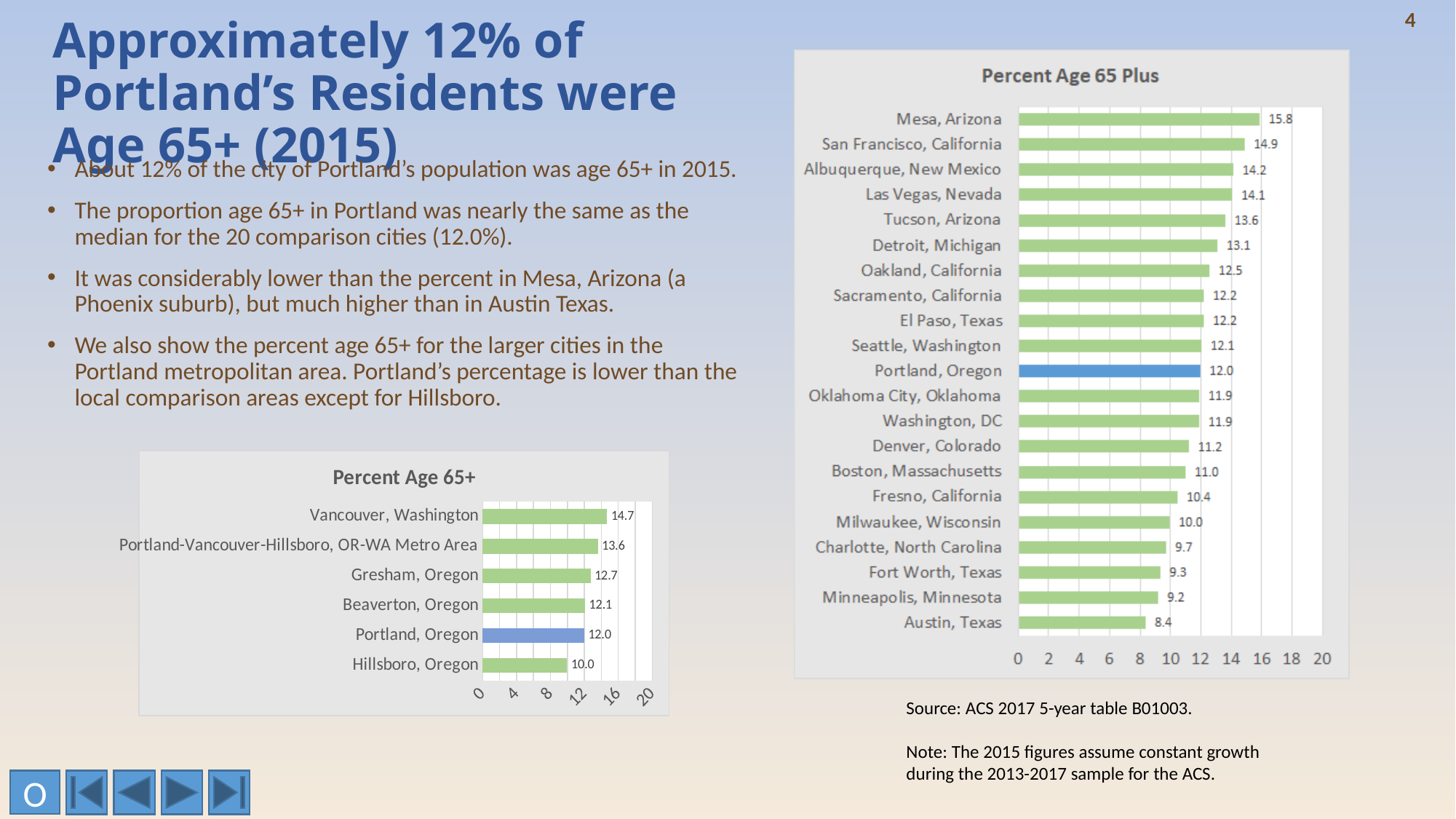
In the 'Percent Age 65+' chart at the bottom left, what is the value for Vancouver, Washington? 14.7 What type of chart is the 'Percent Age 65 Plus' chart on the right? Bar chart In the 'Percent Age 65 Plus' chart on the right, which city has the lowest value? Austin, Texas In the 'Percent Age 65 Plus' chart on the right, what is the value for Mesa, Arizona? 15.8 In the 'Percent Age 65 Plus' chart on the right, which is larger: Detroit, Michigan or Denver, Colorado? Detroit, Michigan In the 'Percent Age 65+' chart at the bottom left, what is the difference between Gresham, Oregon and Portland, Oregon? 0.7 In the 'Percent Age 65 Plus' chart on the right, what is the value for Seattle, Washington? 12.1 In the 'Percent Age 65 Plus' chart on the right, what is the difference between Mesa, Arizona and Austin, Texas? 7.4 In the 'Percent Age 65 Plus' chart on the right, how many cities are shown? 21 In the 'Percent Age 65+' chart at the bottom left, which area has the lowest value? Hillsboro, Oregon In the 'Percent Age 65+' chart at the bottom left, how many areas are shown? 6 In the 'Percent Age 65 Plus' chart on the right, which city has the highest value? Mesa, Arizona